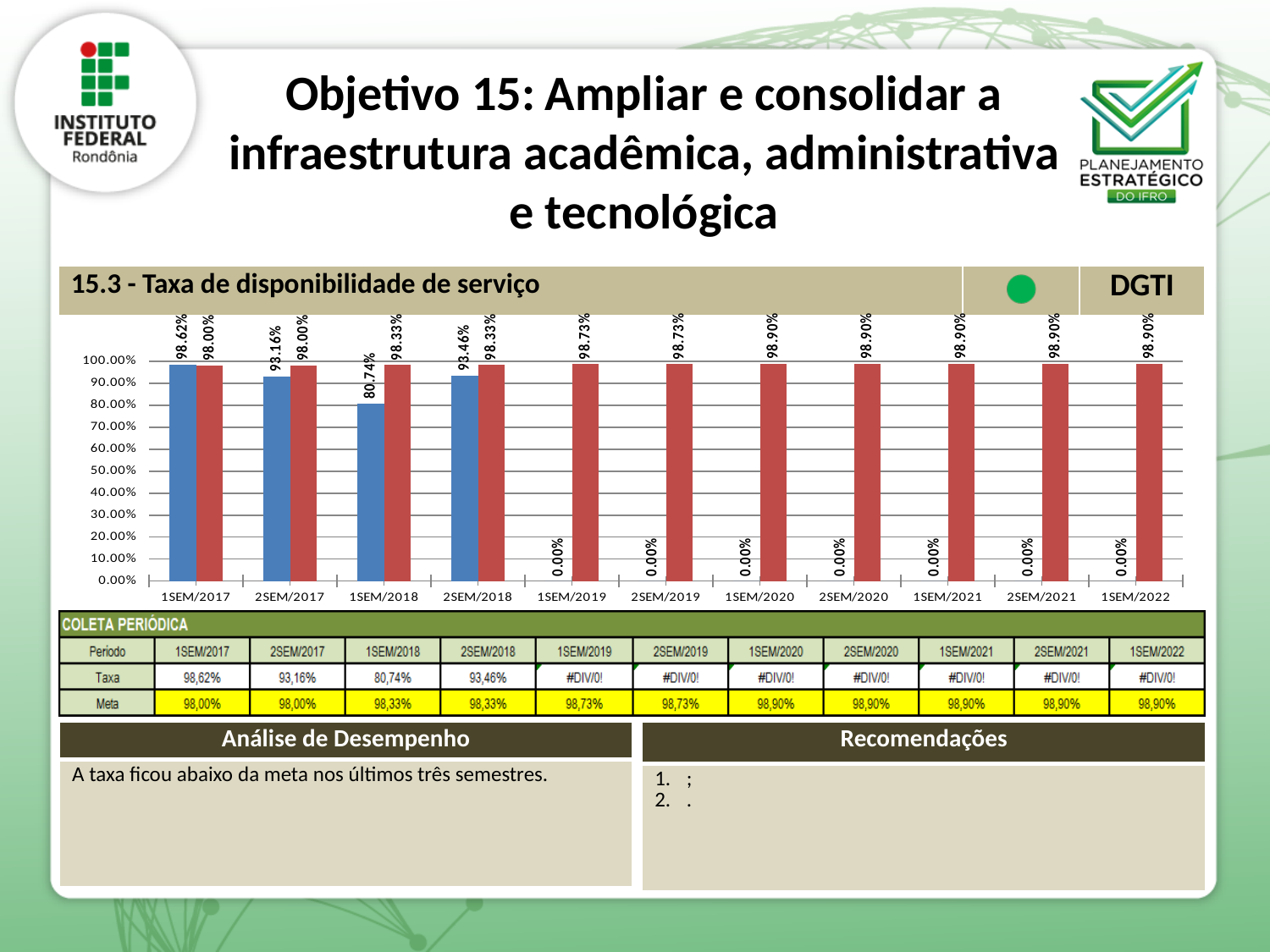
What is the value of the red bar for 1SEM/2022? 98.90% Which period has the highest blue bar? 1SEM/2017 For 1SEM/2018, what is the difference between the red bar and the blue bar? 17.59 percentage points What is the value of the blue bar for 1SEM/2017? 98.62% What type of chart is shown on the slide? Bar chart What is the value of the red bar for 1SEM/2019? 98.73% For 2SEM/2018, what is the difference between the red bar and the blue bar? 4.87 percentage points For 2SEM/2017, which is larger: the blue bar or the red bar? The red bar Among the periods 1SEM/2017 to 2SEM/2018, which has the lowest blue bar? 1SEM/2018 Is the value of the blue bar for 1SEM/2018 greater or less than 90.00%? less How many periods are shown on the x axis of the chart? 11 What is the value of the blue bar for 1SEM/2018? 80.74%